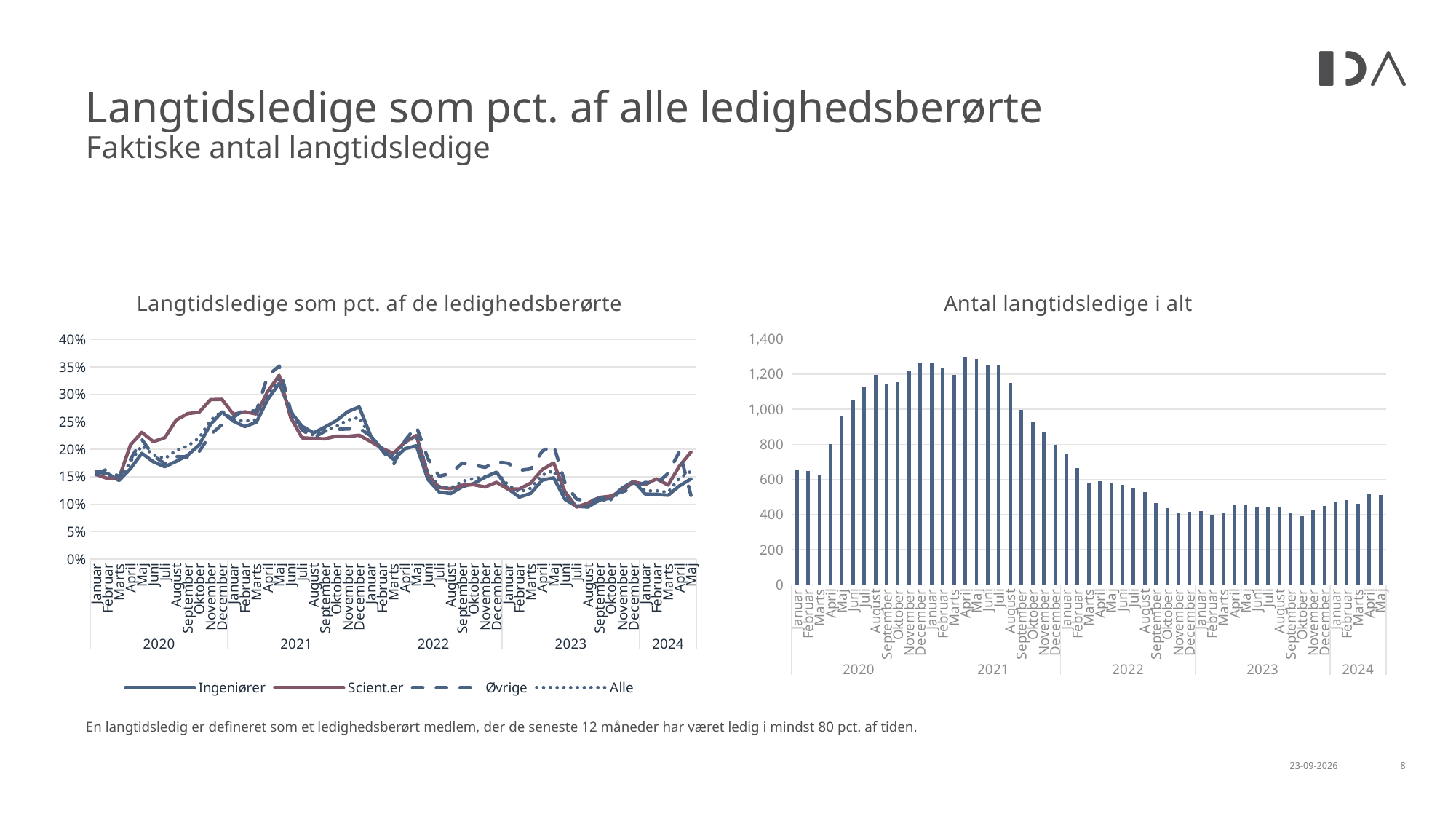
In the left chart, is the Scient.er value for May 2021 greater or less than 30%? greater In the right chart, do the values rise or fall from August 2021 to December 2022? fall What kind of chart is the left chart, 'Langtidsledige som pct. af de ledighedsberørte'? Line chart In the right chart, do the values rise or fall from January 2020 to April 2021? rise What kind of chart is the right chart, 'Antal langtidsledige i alt'? Bar chart How many series does the legend of the left chart list? 4 In the right chart, is the value for January 2020 greater or less than 800? less What is the title of the right chart? Antal langtidsledige i alt In the left chart, is the Ingeniører value for July 2023 greater or less than 15%? less Which series are listed in the legend of the left chart? Ingeniører, Scient.er, Øvrige, Alle